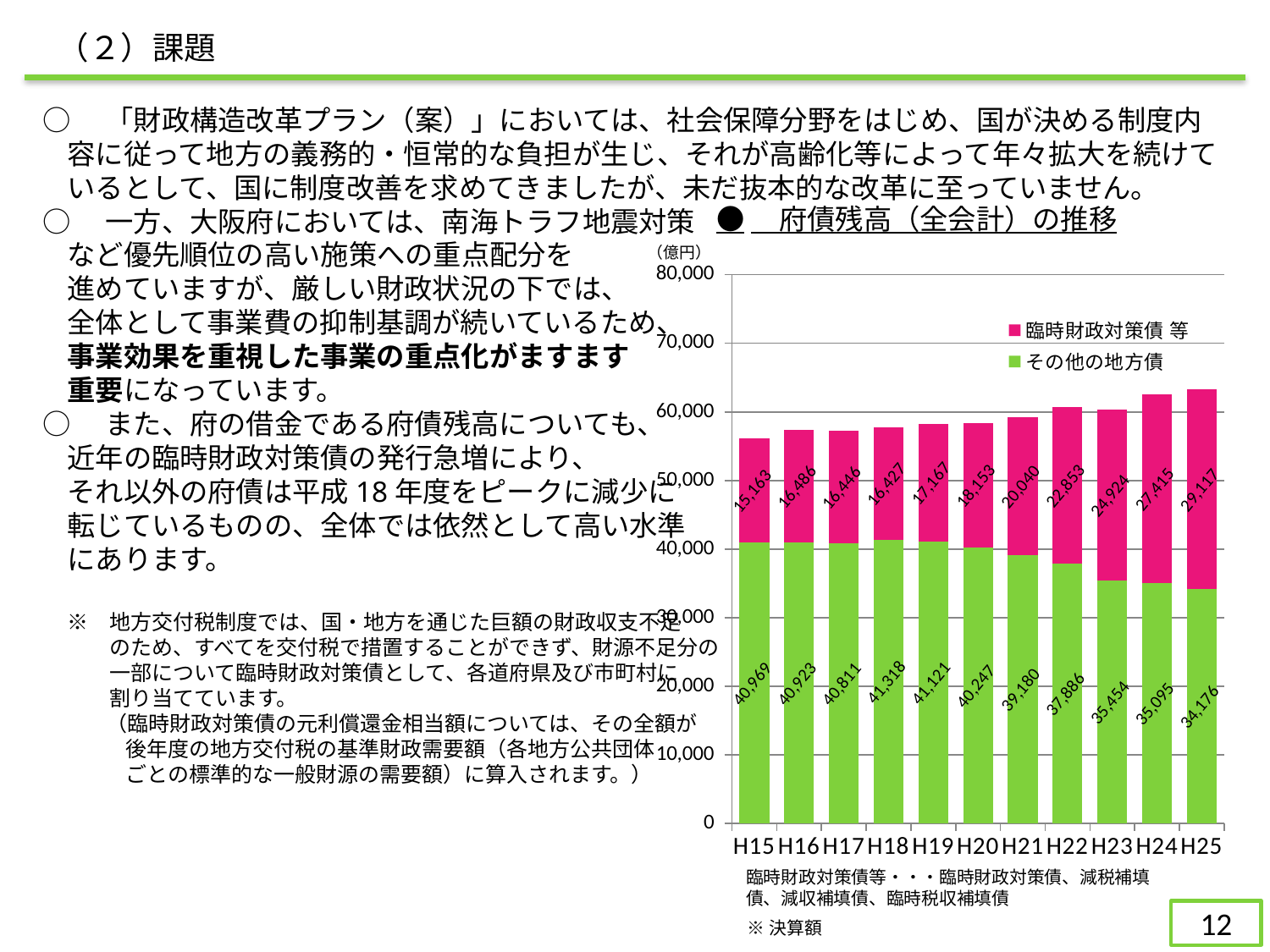
Which is larger: その他の地方債 in H15 or in H25? H15 Does 臨時財政対策債 等 rise or fall from H18 to H25? Rise How many series does the legend of the chart list? 2 In which year is 臨時財政対策債 等 at its lowest? H15 What is the value of 臨時財政対策債 等 for H25? 29,117 Which colour represents 臨時財政対策債 等 in the chart? Pink What is the total of the stacked bar for H25? 63,293 In which year is その他の地方債 at its highest? H18 What kind of chart is shown on the slide? Stacked bar chart What is the difference between 臨時財政対策債 等 in H25 and in H15? 13,954 How many fiscal years are shown on the x axis of the chart? 11 What is the value of その他の地方債 for H18? 41,318